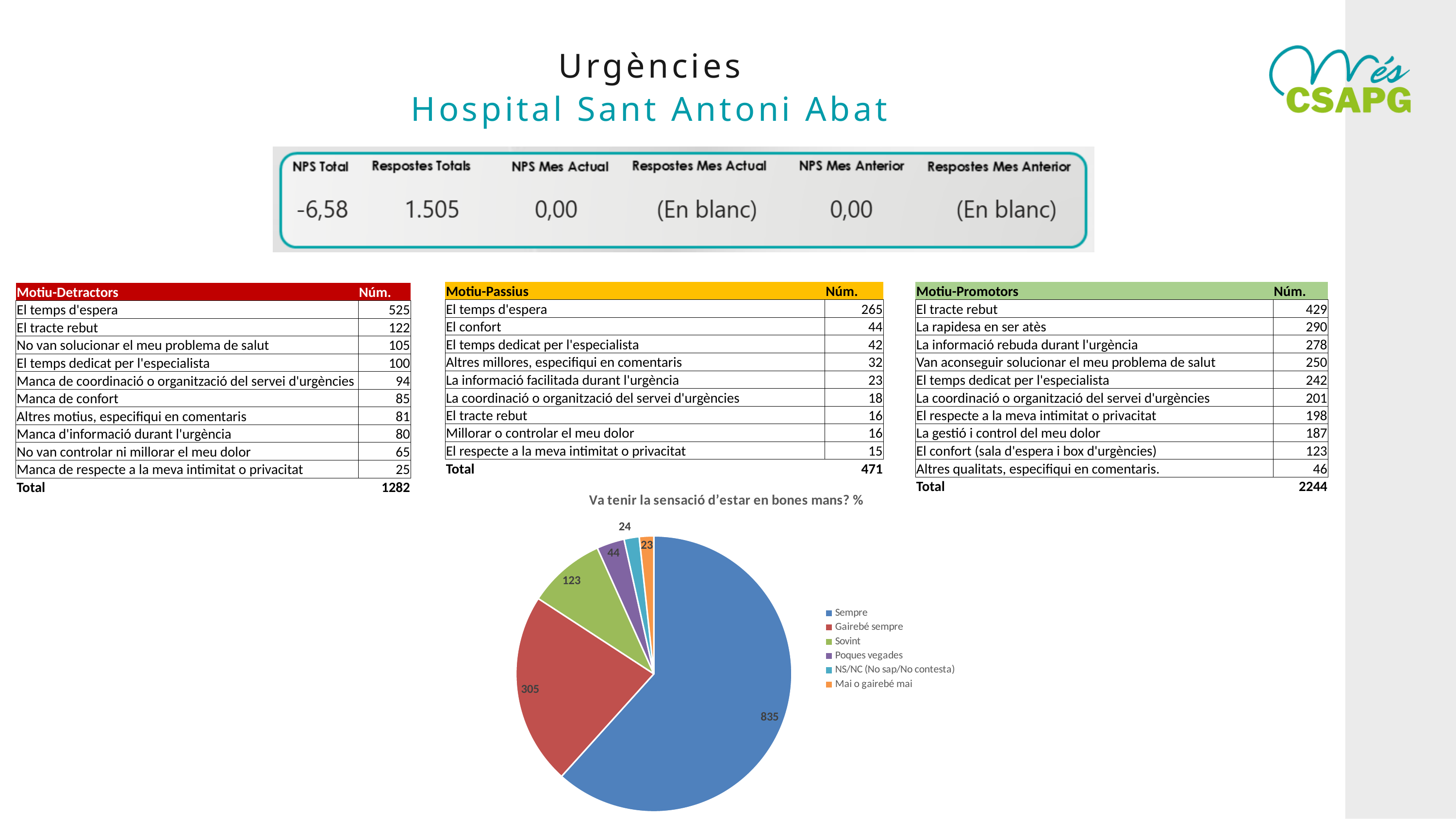
What is the difference between the values for 'Sempre' and 'Gairebé sempre' in the pie chart? 530 What is the value for 'Poques vegades' in the pie chart? 44 What is the value for 'Sempre' in the pie chart? 835 Which is larger in the pie chart, 'Sovint' or 'Poques vegades'? Sovint Which category has the largest slice in the pie chart? Sempre What is the value for 'Gairebé sempre' in the pie chart? 305 How many slices does the pie chart have? 6 What is the value for 'Sovint' in the pie chart? 123 How many entries does the legend of the pie chart list? 6 What colour is the 'Gairebé sempre' slice in the pie chart? red What kind of chart is shown on the slide? pie chart What is the title of the pie chart? Va tenir la sensació d'estar en bones mans? %